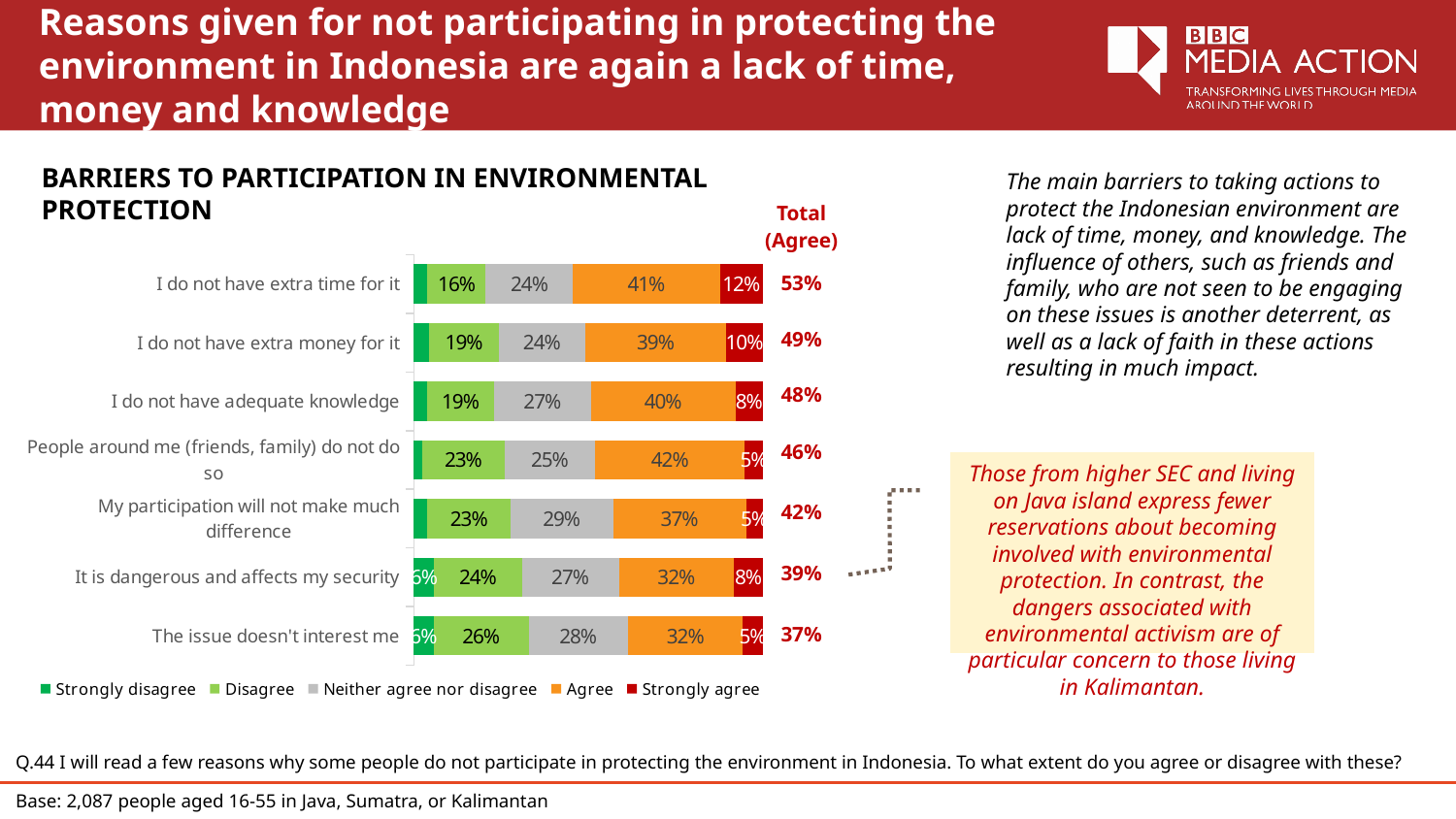
What is the Total (Agree) value for "I do not have adequate knowledge"? 48% How many barriers (categories) are shown in the chart? 7 Which has a larger Agree share: "People around me (friends, family) do not do so" or "It is dangerous and affects my security"? People around me (friends, family) do not do so What is the difference in Total (Agree) between "I do not have extra time for it" and "The issue doesn't interest me"? 16% How many series does the legend list? 5 What type of chart is used to show the barriers to participation? Stacked bar chart What percentage strongly agree with "I do not have extra money for it"? 10% Which barrier has the highest Total (Agree) value? I do not have extra time for it Which barrier has the lowest Total (Agree) value? The issue doesn't interest me Which colour represents "Strongly agree" in the chart? Dark red What percentage of respondents agree (not strongly) with "I do not have extra time for it"? 41% What percentage neither agree nor disagree with "My participation will not make much difference"? 29%